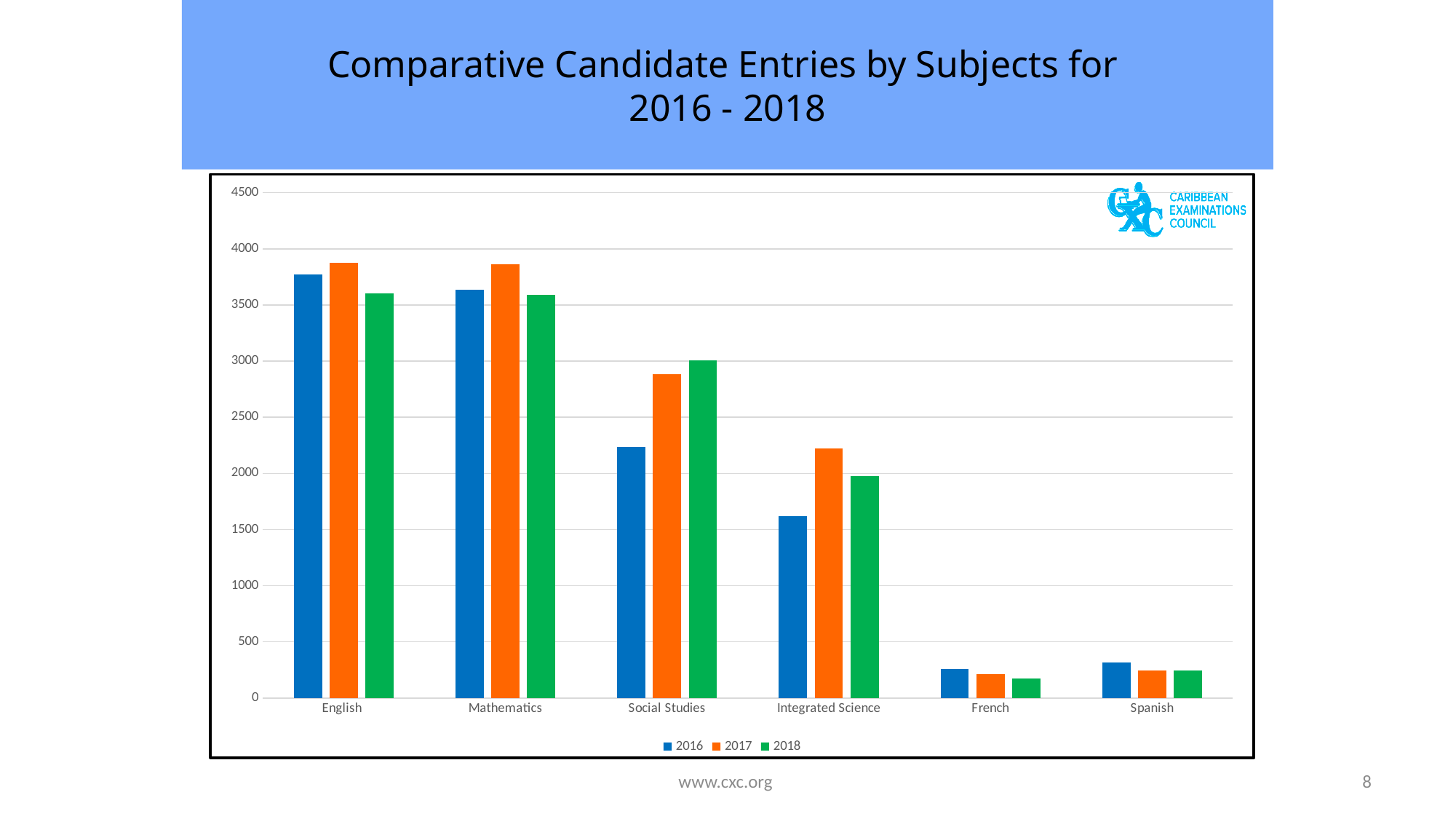
Do the values for French rise or fall from 2016 to 2018? fall For Social Studies, which year has the larger value, 2016 or 2017? 2017 Which years are listed in the legend? 2016, 2017, 2018 How many series does the legend list? 3 Is the 2016 value for English greater or less than 3500? greater How many subjects are shown on the x axis? 6 Is the 2016 value for Integrated Science greater or less than 2000? less Which subject has the lowest 2016 value? French Is the 2016 value for Social Studies greater or less than 2500? less What kind of chart is shown on the slide? bar chart